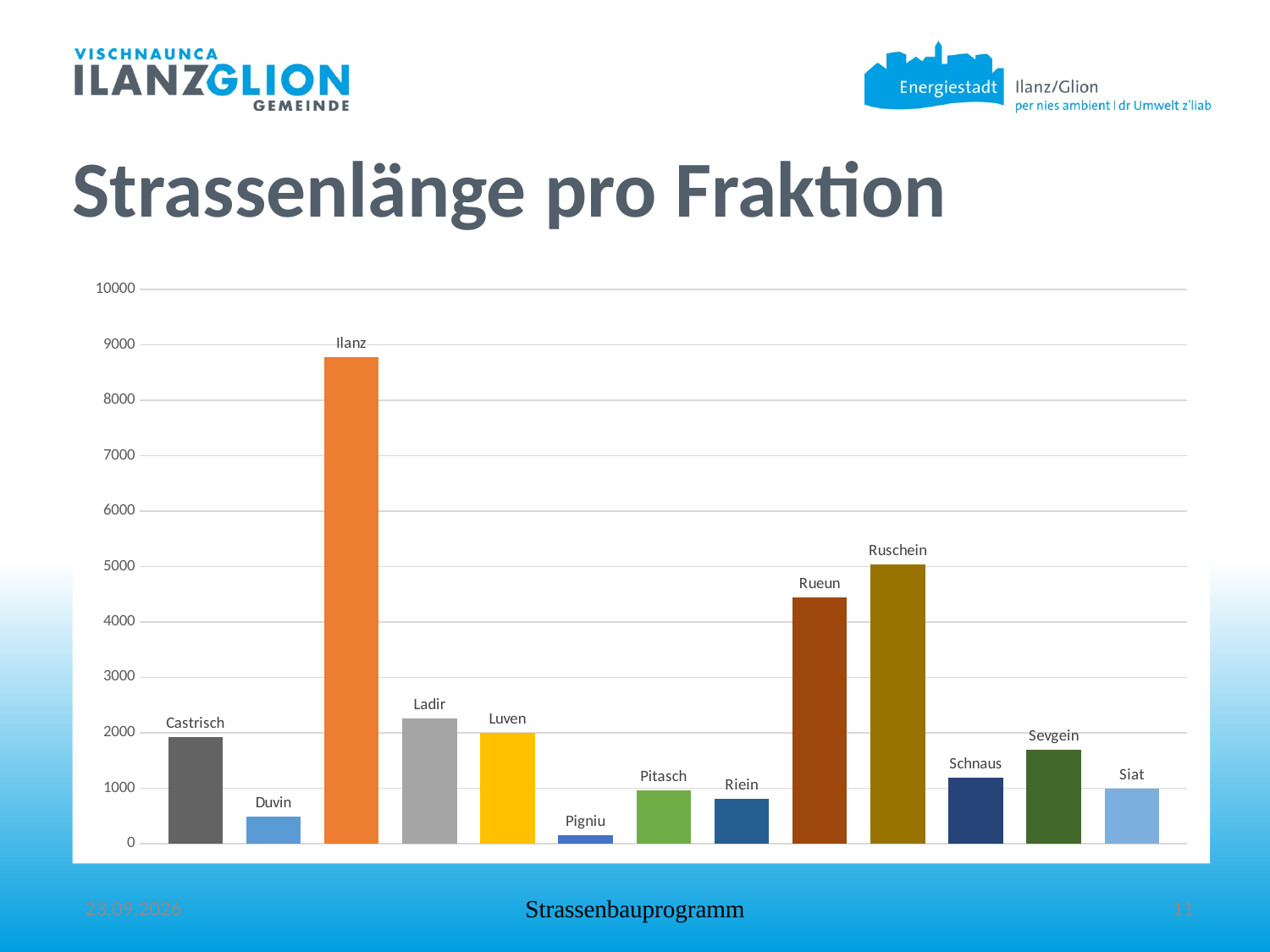
Which category has the highest value in the chart? Ilanz What is the maximum value shown on the vertical axis of the chart? 10000 Which category has the lowest value in the chart? Pigniu What is the title of the slide containing the chart? Strassenlänge pro Fraktion What kind of chart is shown on the slide? bar chart Is the value for Ilanz greater or less than 8000? greater How many categories (Fraktionen) are plotted in the chart? 13 Is the value for Ladir greater or less than 2000? greater Is the value for Rueun greater or less than 4000? greater Which has a larger value, Castrisch or Schnaus? Castrisch Which has a larger value, Ruschein or Rueun? Ruschein